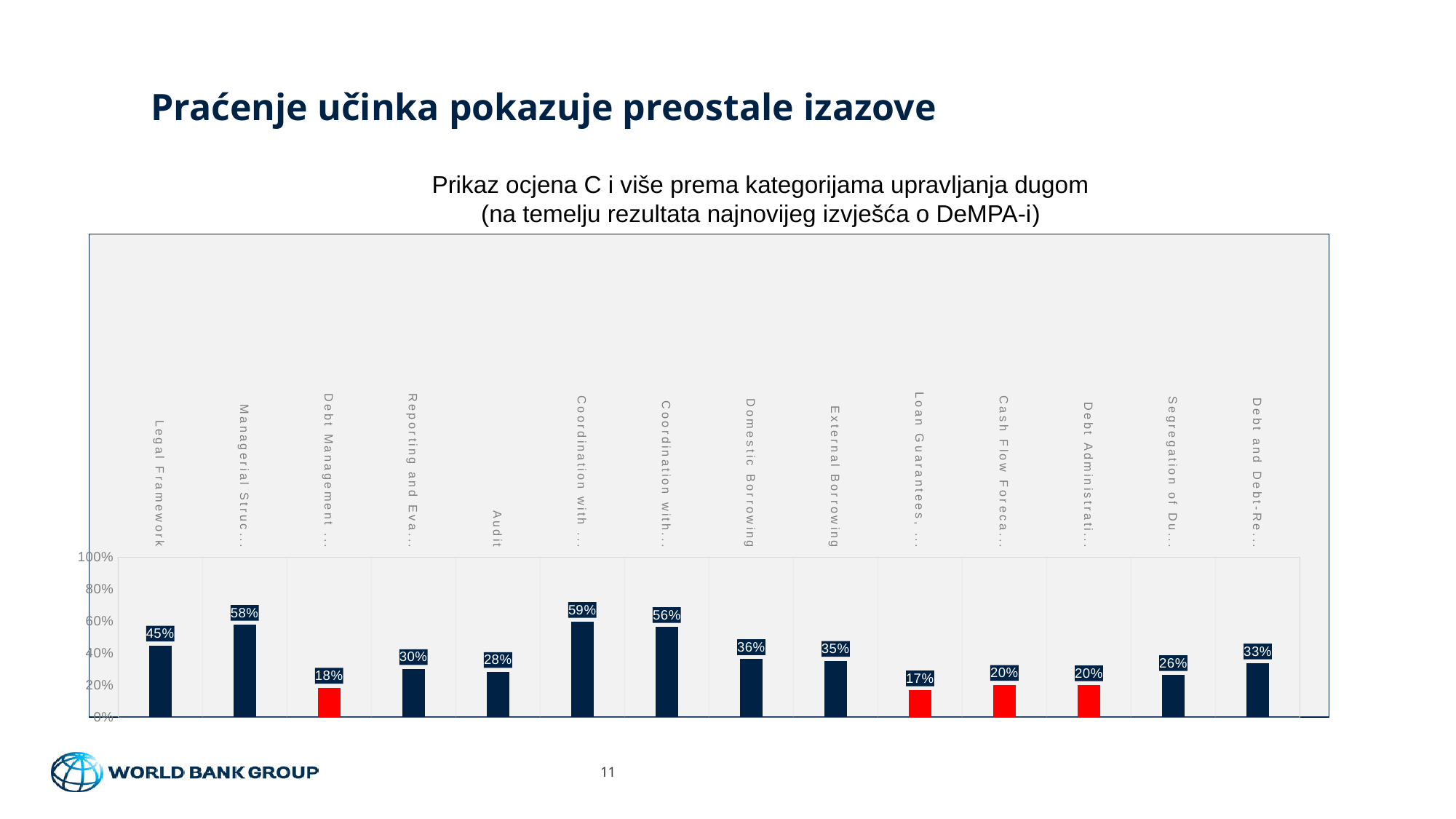
What is the value for Domestic Borrowing? 36% What is the difference between the values for Legal Framework and Audit? 17 percentage points How many bars on the chart are coloured red? 3 What is the lowest value shown on the chart? 17% What is the highest value shown on the chart? 59% What is the value for External Borrowing? 35% Is the value for Audit greater or less than 40%? less What type of chart is shown on the slide? Bar chart Which is larger, the value for Legal Framework or the value for Domestic Borrowing? Legal Framework What is the value for Legal Framework? 45% How many categories are shown on the chart? 14 What is the value for Audit? 28%